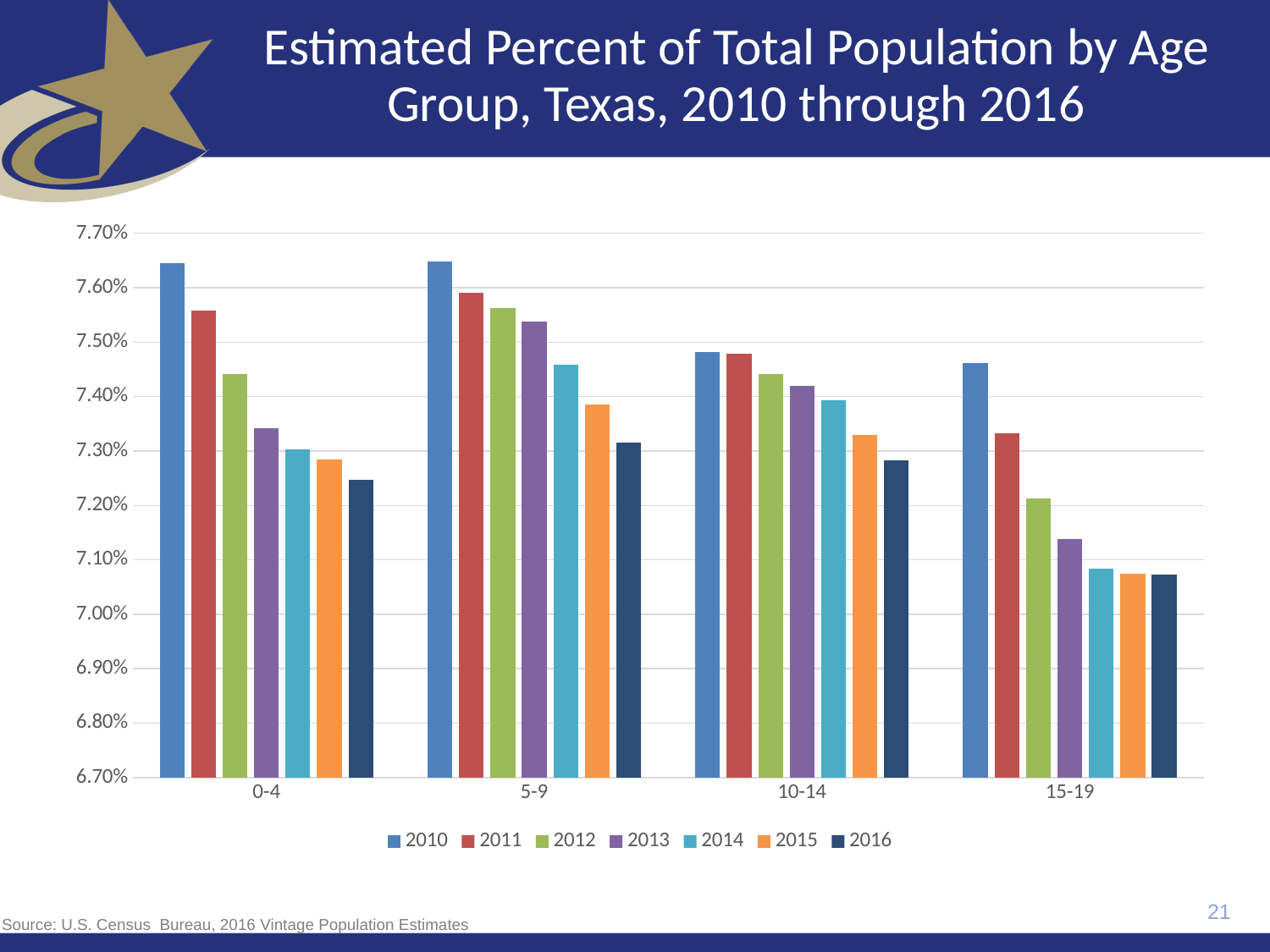
How many series does the legend list? 7 Is the value for 2016 in the 15-19 age group greater or less than 7.10%? less Is the value for 2010 in the 5-9 age group greater or less than 7.60%? greater What kind of chart is shown on the slide? bar chart Is the value for 2011 in the 15-19 age group greater or less than 7.40%? less How many age groups are shown on the x axis? 4 Which age group has the highest value for 2013? 5-9 Which is larger: the 2012 value for the 0-4 age group or the 2012 value for the 15-19 age group? 0-4 Within the 15-19 age group, do the values rise or fall from 2010 to 2016? fall What is the title of the chart? Estimated Percent of Total Population by Age Group, Texas, 2010 through 2016 Which age group has the lowest value for 2016? 15-19